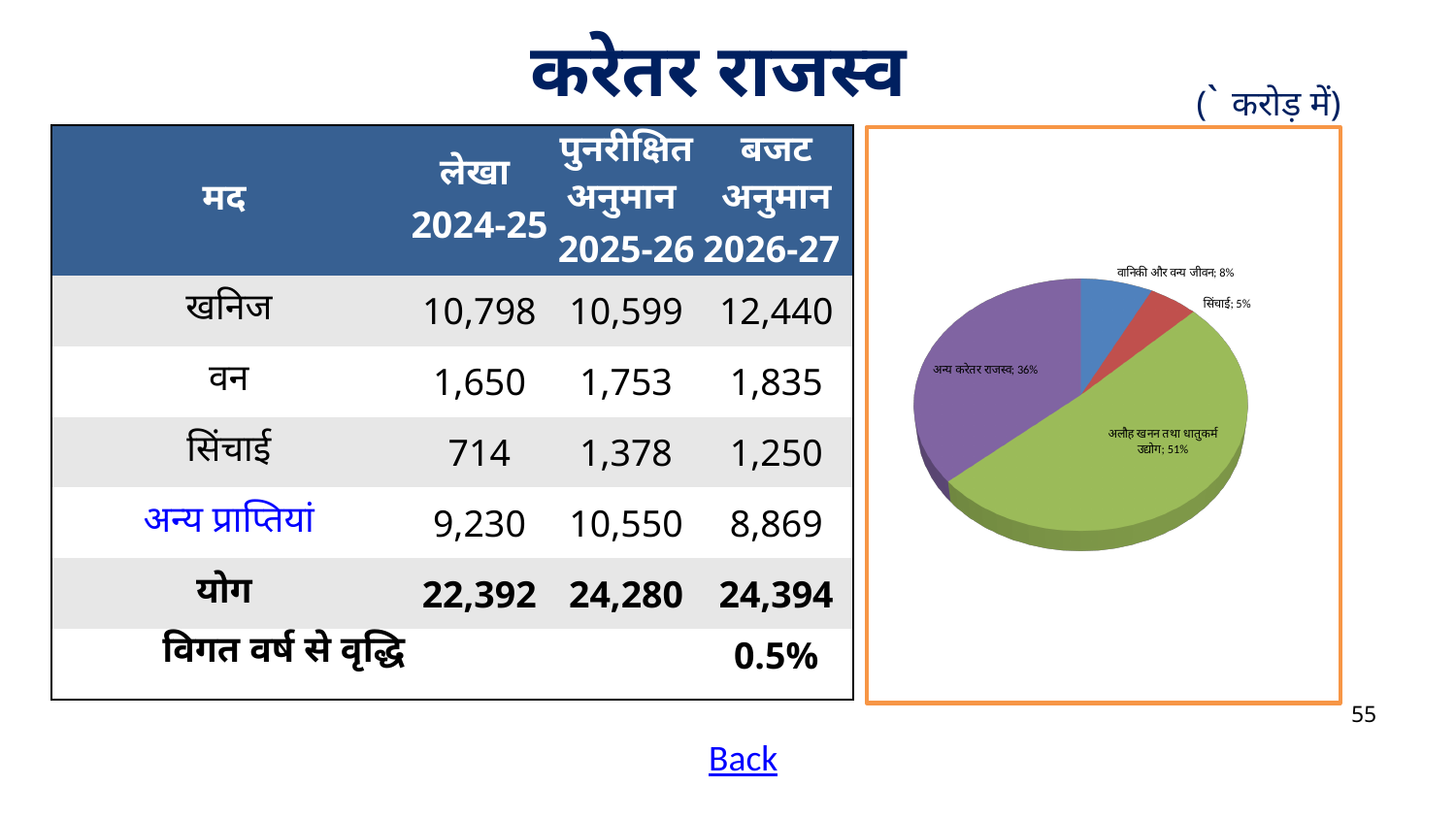
In the pie chart, what share is shown for अलौह खनन तथा धातुकर्म उद्योग? 51% What kind of chart is shown on the right side of the slide? Pie chart Which slice of the pie chart is the smallest? सिंचाई In the pie chart, what share is shown for अन्य करेतर राजस्व? 36% In the pie chart, what share is shown for वानिकी और वन्य जीवन? 8% How many slices does the pie chart have? 4 In the pie chart, what is the difference in percentage points between अलौह खनन तथा धातुकर्म उद्योग and अन्य करेतर राजस्व? 15 What colour is the अलौह खनन तथा धातुकर्म उद्योग slice in the pie chart? Green In the pie chart, which is larger: वानिकी और वन्य जीवन or सिंचाई? वानिकी और वन्य जीवन In the pie chart, what is the combined share of वानिकी और वन्य जीवन and सिंचाई? 13% In the pie chart, what share is shown for सिंचाई? 5% Which slice of the pie chart is the largest? अलौह खनन तथा धातुकर्म उद्योग